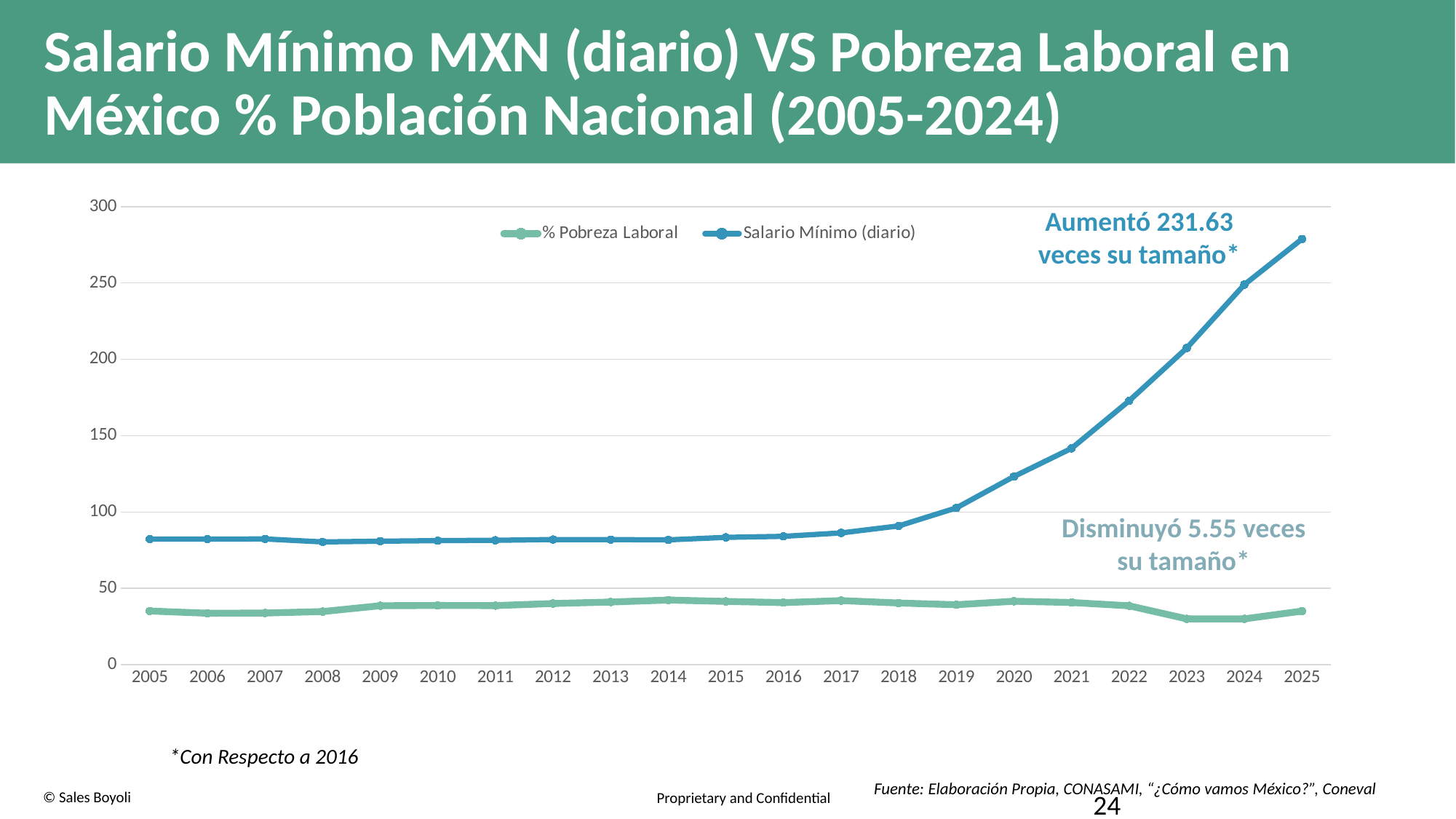
Is the Salario Mínimo (diario) value for 2022 greater or less than 150? greater Is the Salario Mínimo (diario) value for 2005 greater or less than 100? less How many series does the legend list? 2 Which series has the larger value in 2020, % Pobreza Laboral or Salario Mínimo (diario)? Salario Mínimo (diario) What kind of chart is shown on the slide? Line chart Is the % Pobreza Laboral value for 2025 greater or less than 50? less In which year is the Salario Mínimo (diario) value highest? 2025 Which is larger for Salario Mínimo (diario): the value in 2005 or the value in 2025? 2025 Does the Salario Mínimo (diario) series rise or fall from 2018 to 2025? Rise How many years are plotted along the x axis? 21 According to the annotation on the chart, by how many times did the Salario Mínimo increase in size? 231.63 veces